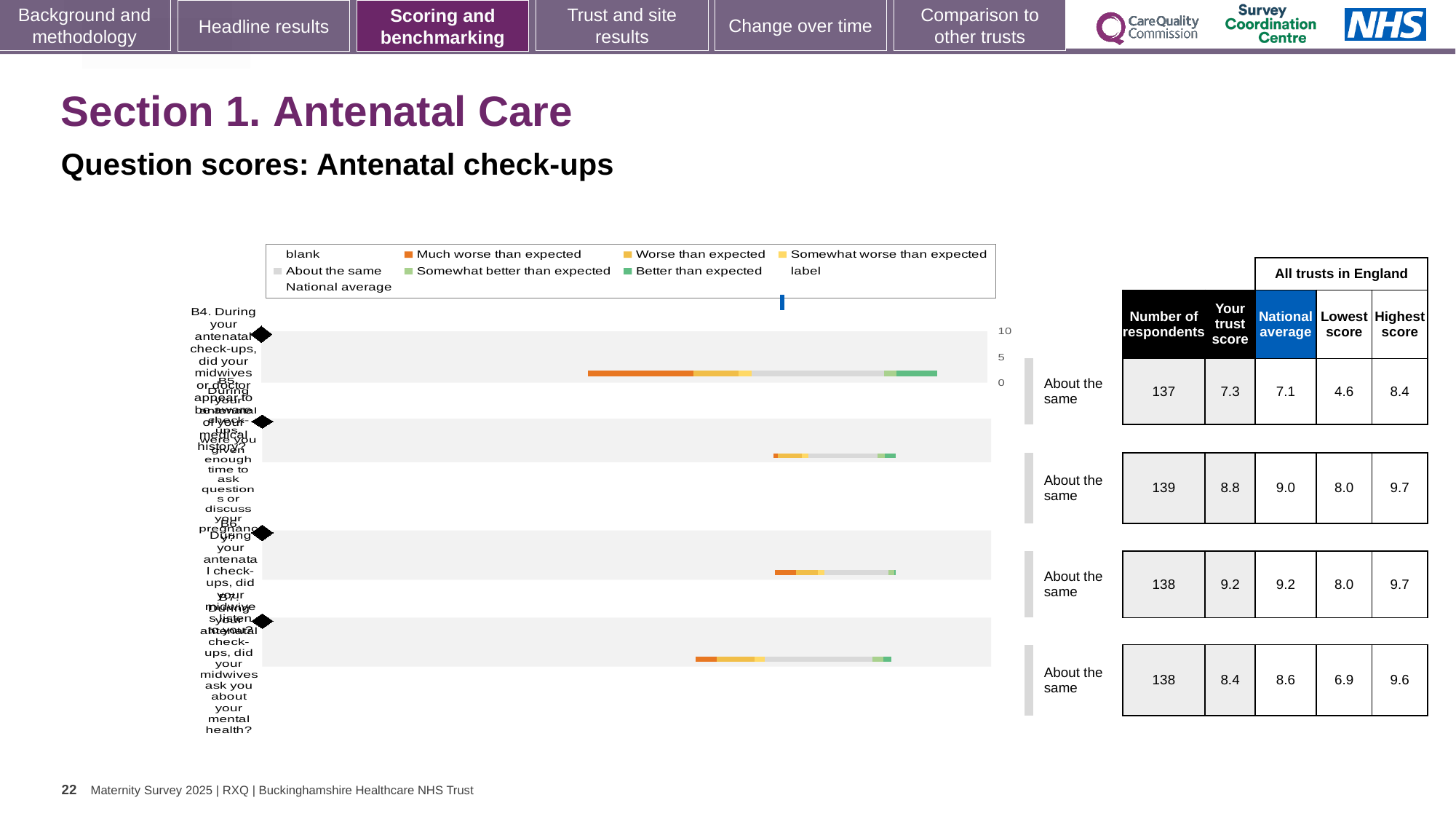
What benchmark category is shown next to every bar in the chart? About the same How many question bars are plotted in the chart? 4 For the bottom bar (B7), is the trust score (8.4) larger or smaller than the national average (8.6)? smaller In the chart legend, which colour represents 'Much worse than expected'? orange What is the national average shown for the top bar (B4, about midwives or doctor being aware of your medical history)? 7.1 What is the 'Your trust score' shown for the top bar (B4, about midwives or doctor being aware of your medical history)? 7.3 What is the highest score across all trusts in England shown for the bottom bar (B7, about midwives asking about your mental health)? 9.6 What is the 'Your trust score' shown for the bottom bar (B7, about midwives asking about your mental health)? 8.4 In the chart legend, which colour represents 'Better than expected'? green For the top bar (B4), what is the difference between the highest score (8.4) and the lowest score (4.6) across all trusts in England? 3.8 What is the number of respondents shown for the bottom bar (B7, about midwives asking about your mental health)? 138 What kind of chart is shown on the slide? bar chart